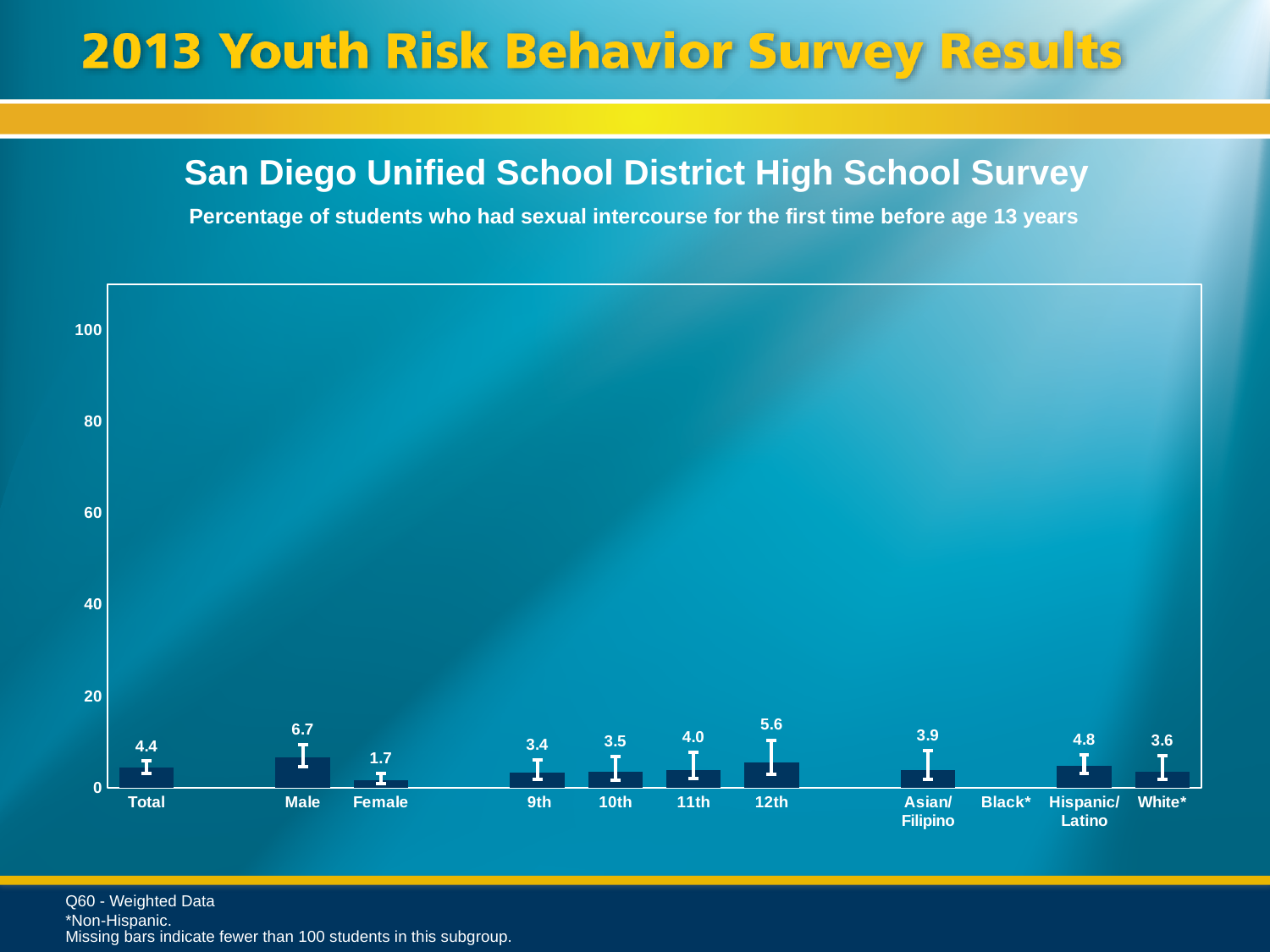
Do the values rise or fall from 9th grade to 12th grade? rise Which is larger, the value for Hispanic/Latino or the value for White*? Hispanic/Latino Is the value for Total greater or less than 20? less Which category has the lowest value among those with bars shown? Female What kind of chart is shown? bar chart Which category has no bar shown? Black* What is the value for Female? 1.7 What is the value for Asian/Filipino? 3.9 What is the value for 12th grade? 5.6 What is the difference between the Male and Female values? 5.0 Which category has the highest value? Male What is the value for Male? 6.7